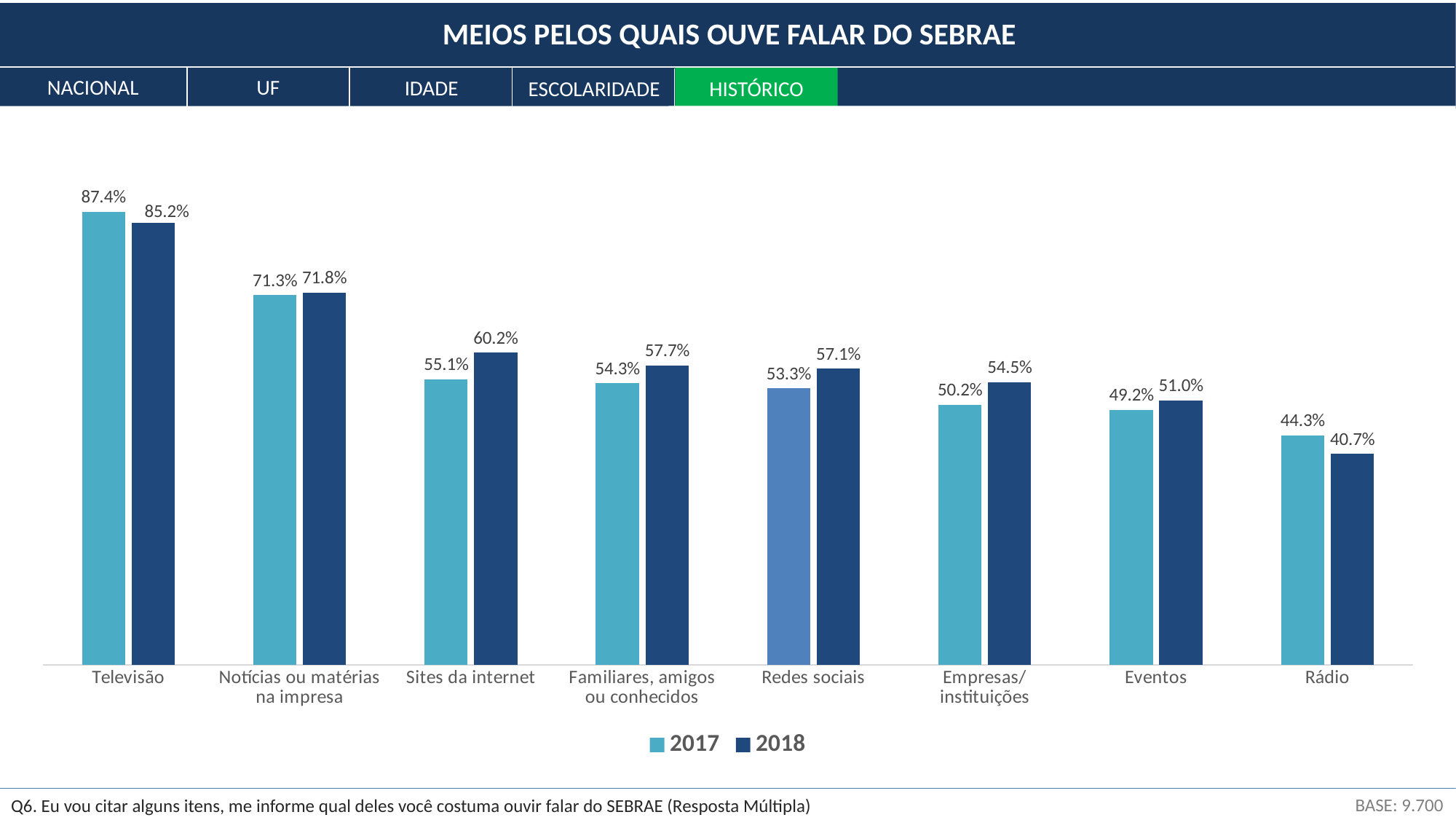
How many series does the legend list? 2 Which is larger for Rádio, the 2017 value or the 2018 value? 2017 What is the difference between the 2017 and 2018 values for Sites da internet? 5.1% Which category has the lowest 2018 value? Rádio What is the 2017 value for Redes sociais? 53.3% Which is larger for Familiares, amigos ou conhecidos, the 2017 value or the 2018 value? 2018 Which category has the highest 2017 value? Televisão How many categories are shown on the x axis? 8 What is the 2018 value for Rádio? 40.7% What is the 2018 value for Televisão? 85.2% What is the title of the chart? MEIOS PELOS QUAIS OUVE FALAR DO SEBRAE What kind of chart is shown on the slide? Bar chart